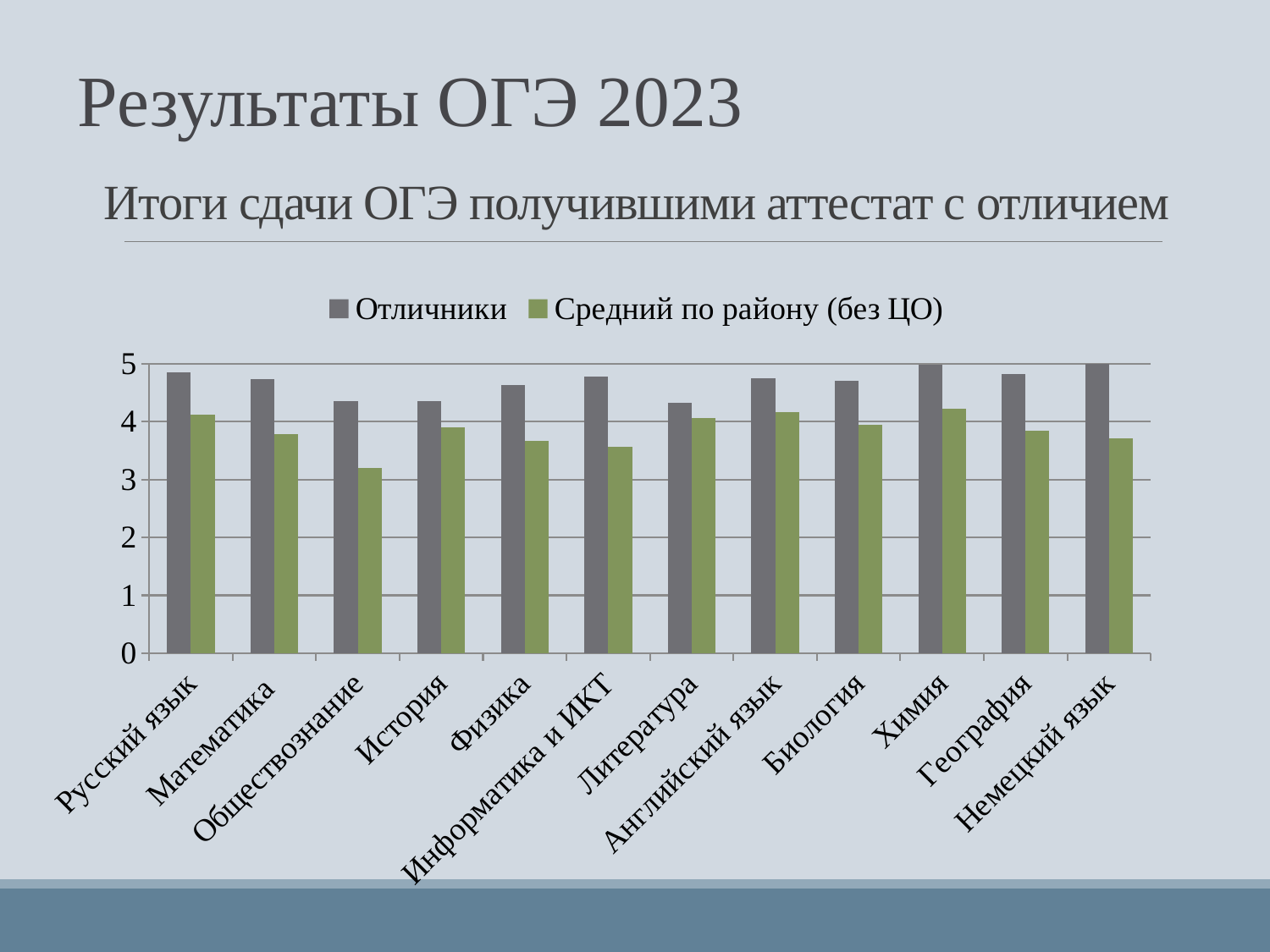
Is the value for 'Средний по району (без ЦО)' for Обществознание greater or less than 4? less Is the value for 'Средний по району (без ЦО)' for Математика greater or less than 4? less For the series 'Средний по району (без ЦО)', which is larger: Обществознание or История? История Is the value for 'Отличники' for Русский язык greater or less than 4? greater Which subject has the lowest value for the series 'Средний по району (без ЦО)'? Обществознание How many subjects (categories) are shown on the x axis of the chart? 12 Which series is shown in green in the chart? Средний по району (без ЦО) What is the title of the chart on the slide? Итоги сдачи ОГЭ получившими аттестат с отличием How many series does the chart legend list? 2 For Физика, which series has the larger value: 'Отличники' or 'Средний по району (без ЦО)'? Отличники What kind of chart is shown on the slide? bar chart